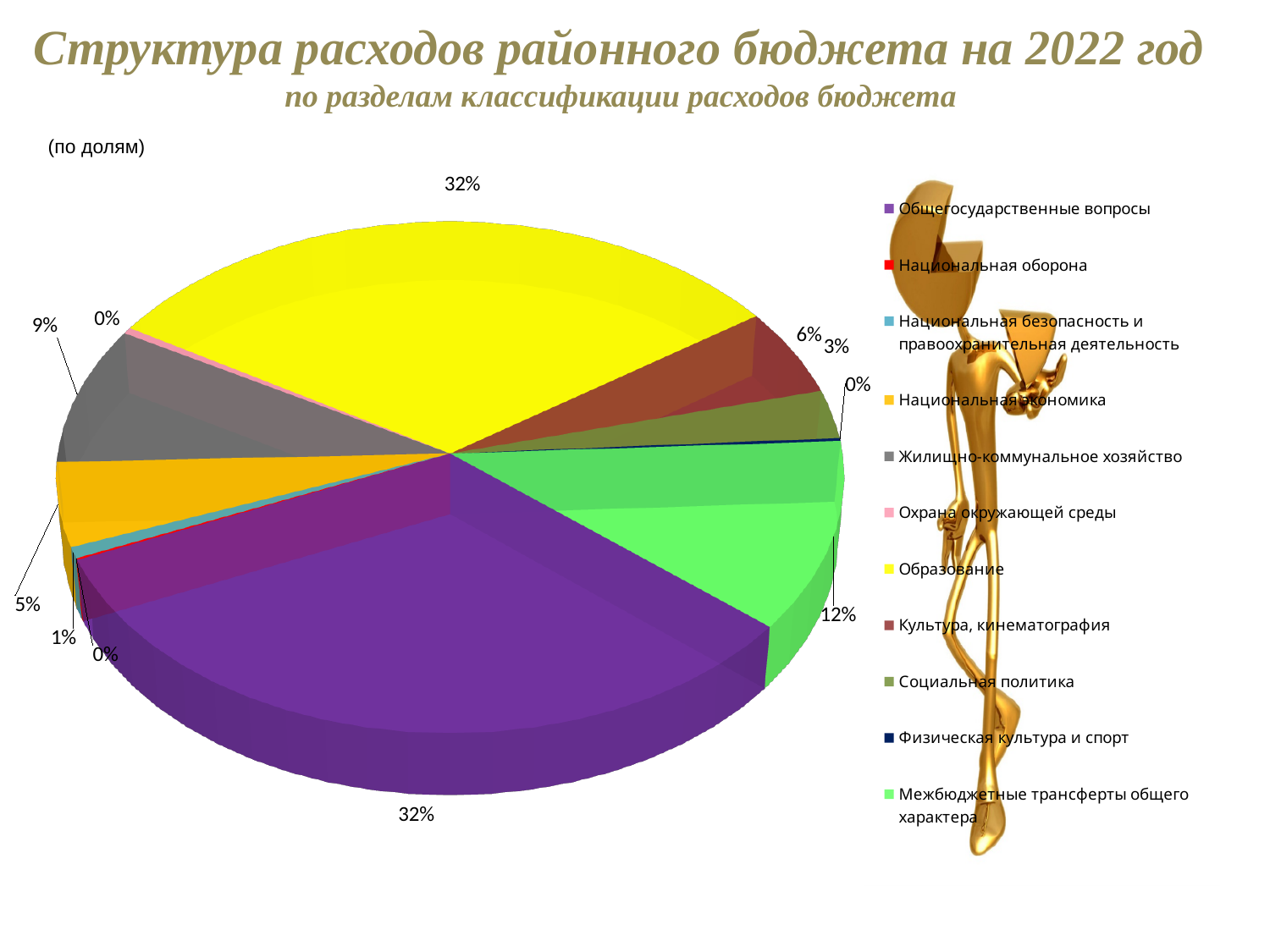
What share of the budget expenditure goes to Социальная политика? 3% What share of the budget expenditure goes to Культура, кинематография? 6% What is the combined share of Общегосударственные вопросы and Образование? 64% What is the difference in percentage points between the shares for Межбюджетные трансферты общего характера and Жилищно-коммунальное хозяйство? 3 What share of the budget expenditure goes to Межбюджетные трансферты общего характера? 12% What share of the budget expenditure goes to Жилищно-коммунальное хозяйство? 9% What type of chart is shown on the slide? pie chart What year does the chart title refer to? 2022 What share of the budget expenditure goes to Образование? 32% Which has a larger share: Культура, кинематография or Национальная экономика? Культура, кинематография What share of the budget expenditure goes to Национальная экономика? 5% How many categories does the legend list? 11